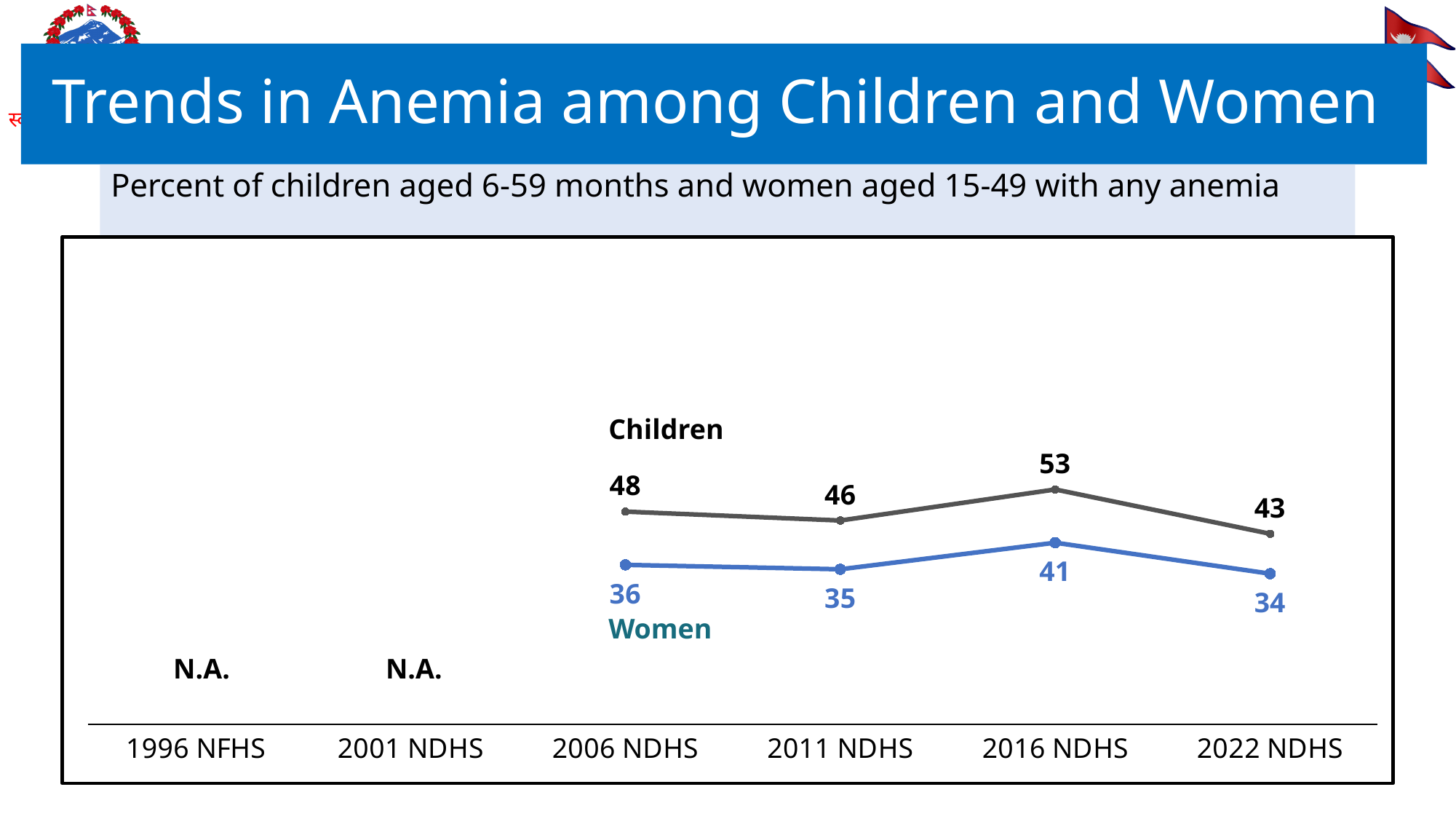
In which survey year is the Women value lowest? 2022 NDHS What kind of chart is shown? Line chart What is the difference between the Children and Women values in 2016 NDHS? 12 In which survey year is the Children value highest? 2016 NDHS What is the value for Children in 2011 NDHS? 46 Which is larger in 2006 NDHS, the Children value or the Women value? Children What is the value for Children in 2016 NDHS? 53 How many series are plotted on the chart? 2 What is the value for Women in 2006 NDHS? 36 What is the value for Women in 2022 NDHS? 34 Which survey years show N.A. instead of a value? 1996 NFHS and 2001 NDHS What is the difference between the Children values in 2016 NDHS and 2022 NDHS? 10